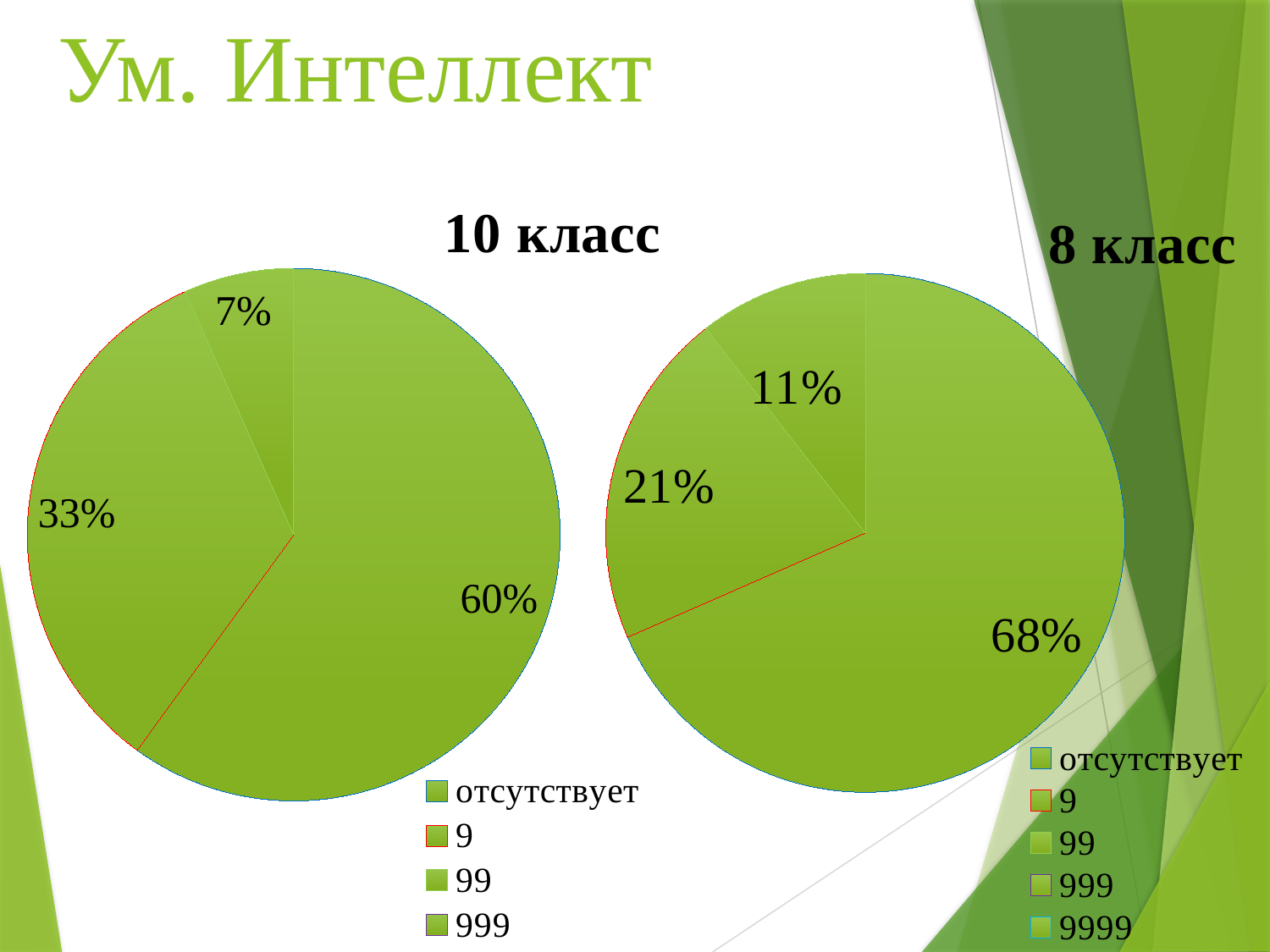
How many entries does the legend of the "8 класс" chart list? 5 What is the title of the pie chart on the left of the slide? 10 класс In the "8 класс" chart, what is the difference in percentage points between the largest slice and the second-largest slice? 47 percentage points In the "8 класс" chart, what is the percentage of the largest slice? 68% What kind of chart is the "10 класс" chart? pie chart In the "8 класс" chart, what is the percentage of the smallest slice? 11% Which chart has the larger biggest slice, "10 класс" or "8 класс"? 8 класс How many entries does the legend of the "10 класс" chart list? 4 How many slices with percentage labels are shown in the "8 класс" chart? 3 In the "10 класс" chart, what is the percentage of the largest slice? 60% In the "10 класс" chart, what is the percentage of the smallest slice? 7% In the "10 класс" chart, what is the difference in percentage points between the largest slice and the second-largest slice? 27 percentage points